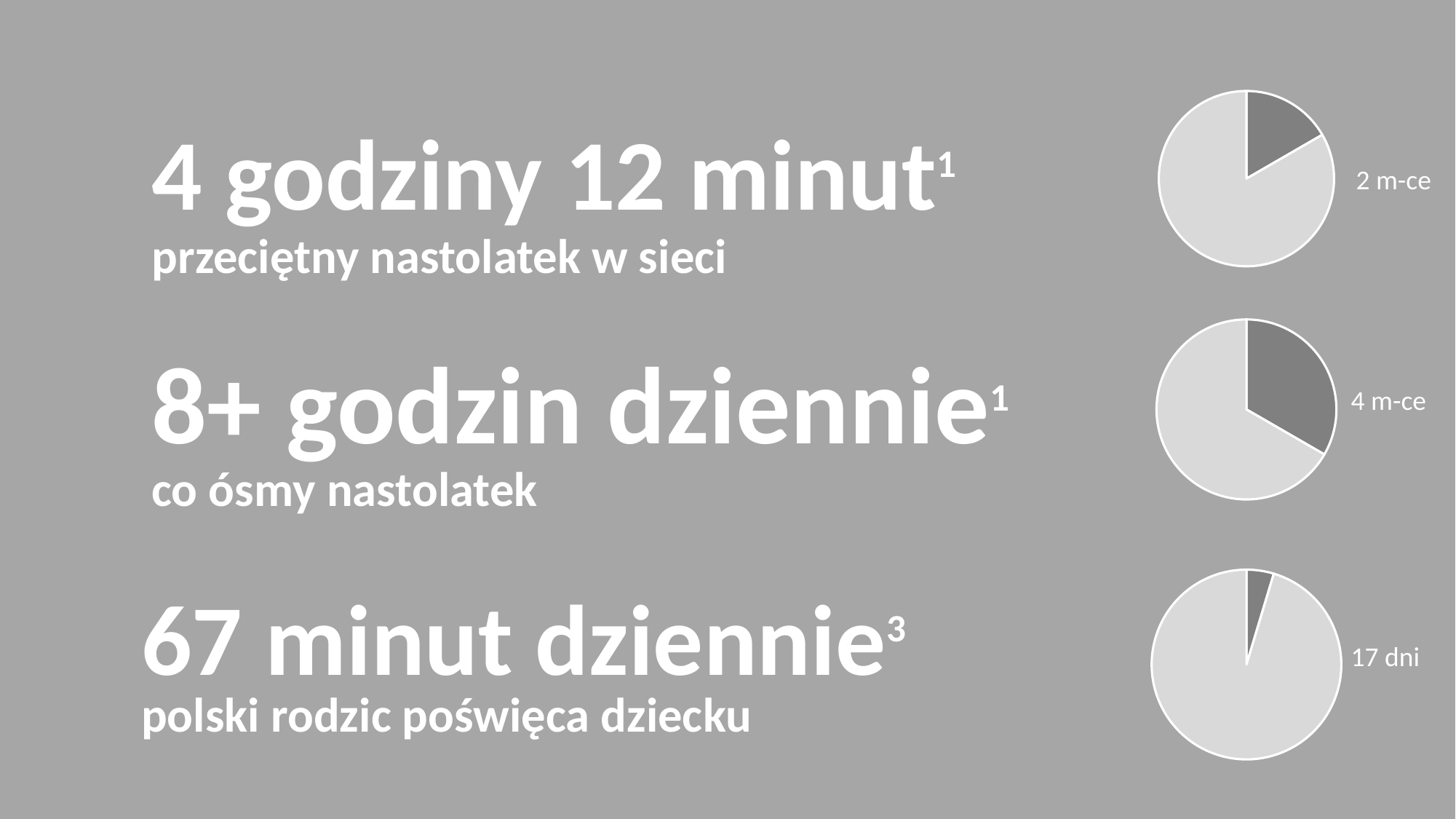
How many slices does the bottom pie chart (labelled 17 dni) have? 2 How many pie charts are on the slide? 3 Is the dark slice larger in the top pie chart (2 m-ce) or in the bottom pie chart (17 dni)? the top pie chart (2 m-ce) What label is printed next to the middle pie chart? 4 m-ce Which of the three pie charts has the largest dark slice? the middle one (4 m-ce) Which of the three pie charts has the smallest dark slice? the bottom one (17 dni) In the middle pie chart (4 m-ce), is the dark slice larger or smaller than the light slice? smaller What label is printed next to the top pie chart? 2 m-ce Is the dark slice larger in the top pie chart (2 m-ce) or in the middle pie chart (4 m-ce)? the middle pie chart (4 m-ce) What kind of chart is shown at the top right of the slide? pie chart